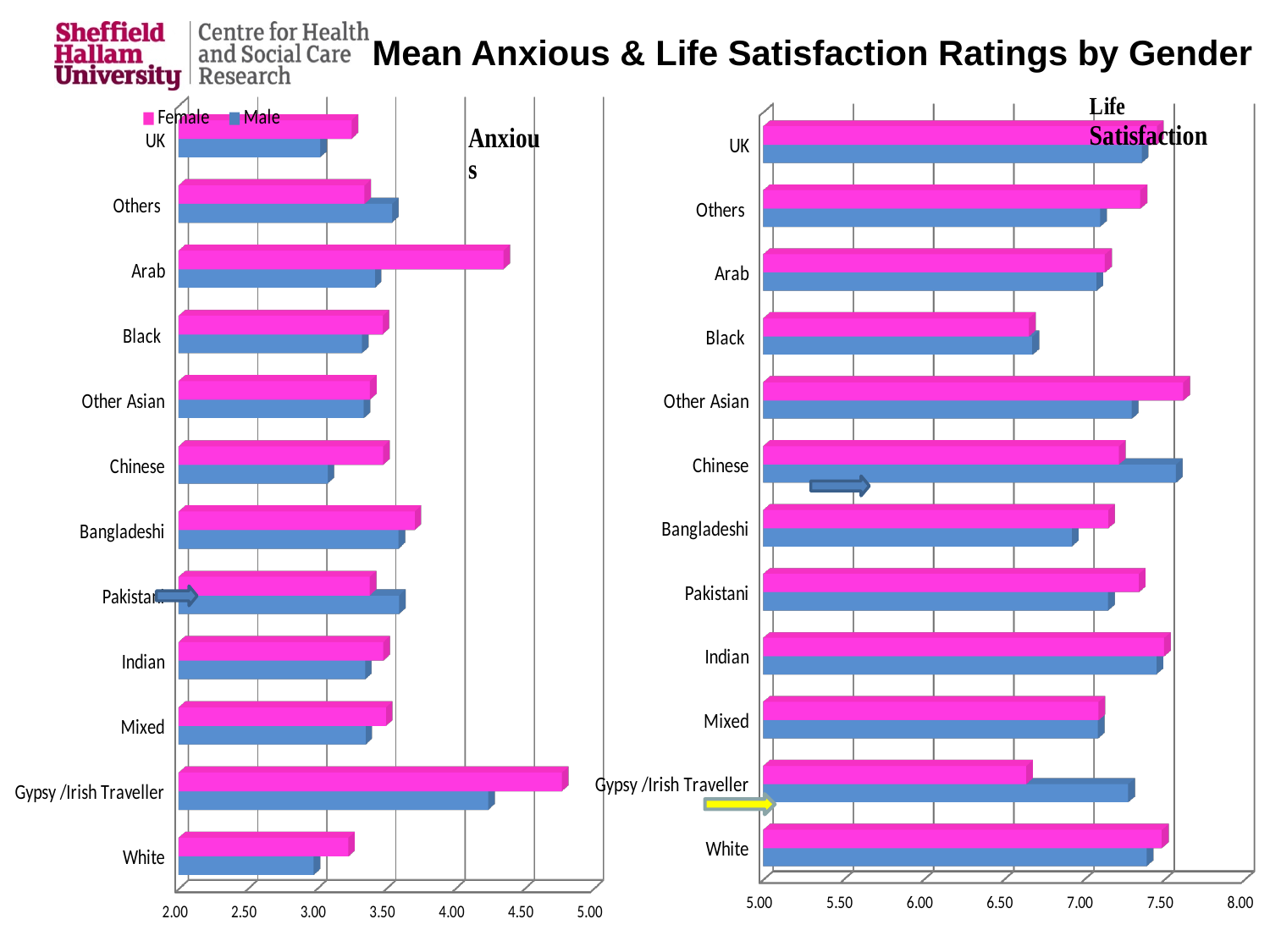
On the Anxious chart, which category has the highest Male value? Gypsy /Irish Traveller On the Life Satisfaction chart, which is larger for Gypsy /Irish Traveller, the Female value or the Male value? Male On the Anxious chart, which category has the highest Female value? Gypsy /Irish Traveller How many series does the legend on the Anxious chart list? 2 What kind of chart is the Anxious chart on the left of the slide? bar chart On the Life Satisfaction chart, which category has the highest Male value? Chinese On the Anxious chart, is the Male value for White greater or less than 3.50? less On the Life Satisfaction chart, is the Female value for Black greater or less than 7.00? less On the Life Satisfaction chart, is the Male value for Chinese greater or less than 7.50? greater How many categories are plotted on the Life Satisfaction chart? 12 On the Anxious chart, which colour represents the Female series? pink